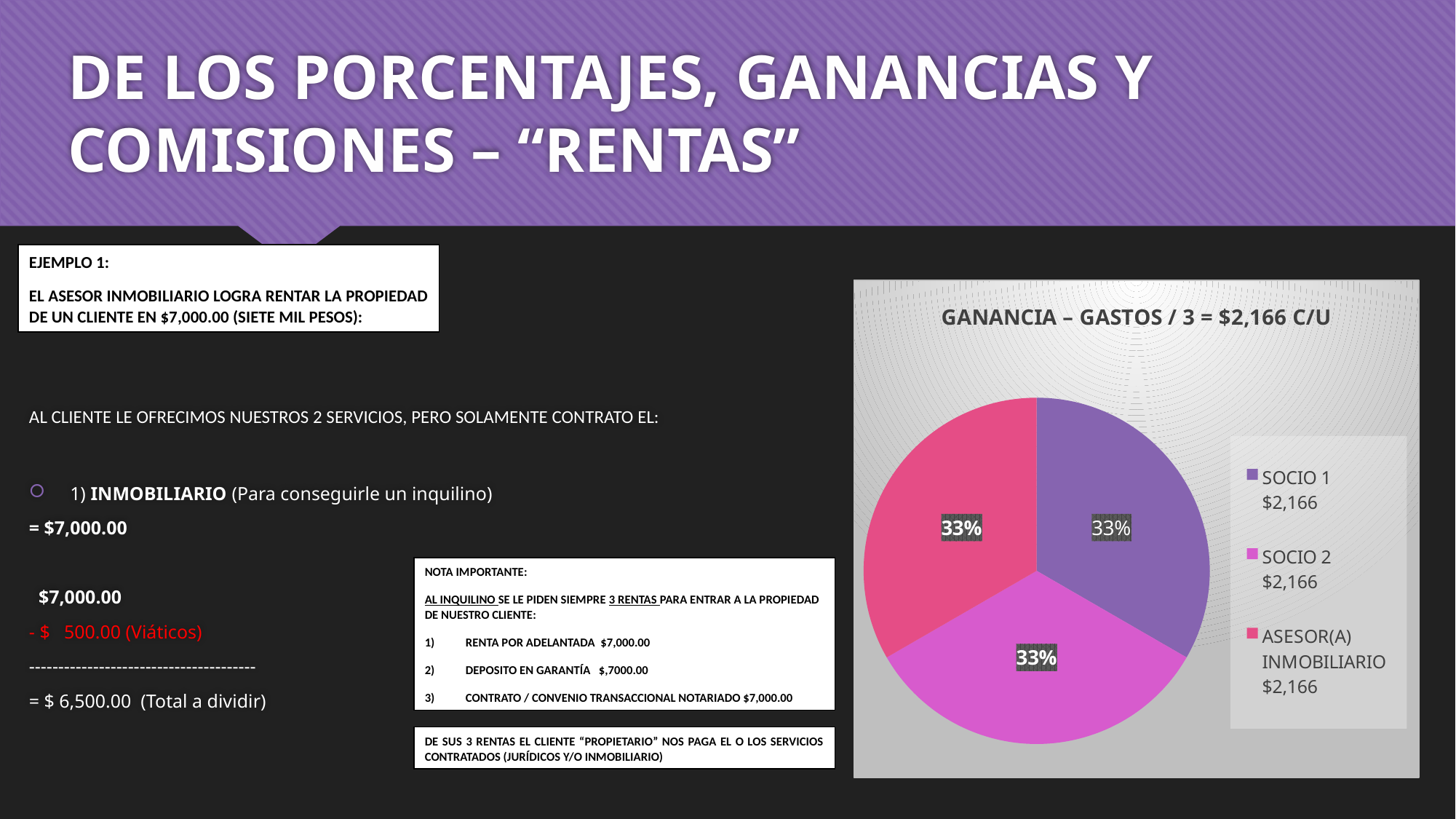
What share of the pie does SOCIO 1 represent? 33% How many slices does the pie chart have? 3 What amount is shown in the legend for SOCIO 1? $2,166 What share of the pie does SOCIO 2 represent? 33% How many entries does the legend of the pie chart list? 3 What is the title of the pie chart? GANANCIA – GASTOS / 3 = $2,166 C/U What kind of chart is shown on the slide? pie chart What amount is shown in the legend for ASESOR(A) INMOBILIARIO? $2,166 Which legend entry is shown in purple in the pie chart? SOCIO 1 What share of the pie does ASESOR(A) INMOBILIARIO represent? 33% What amount is shown in the legend for SOCIO 2? $2,166